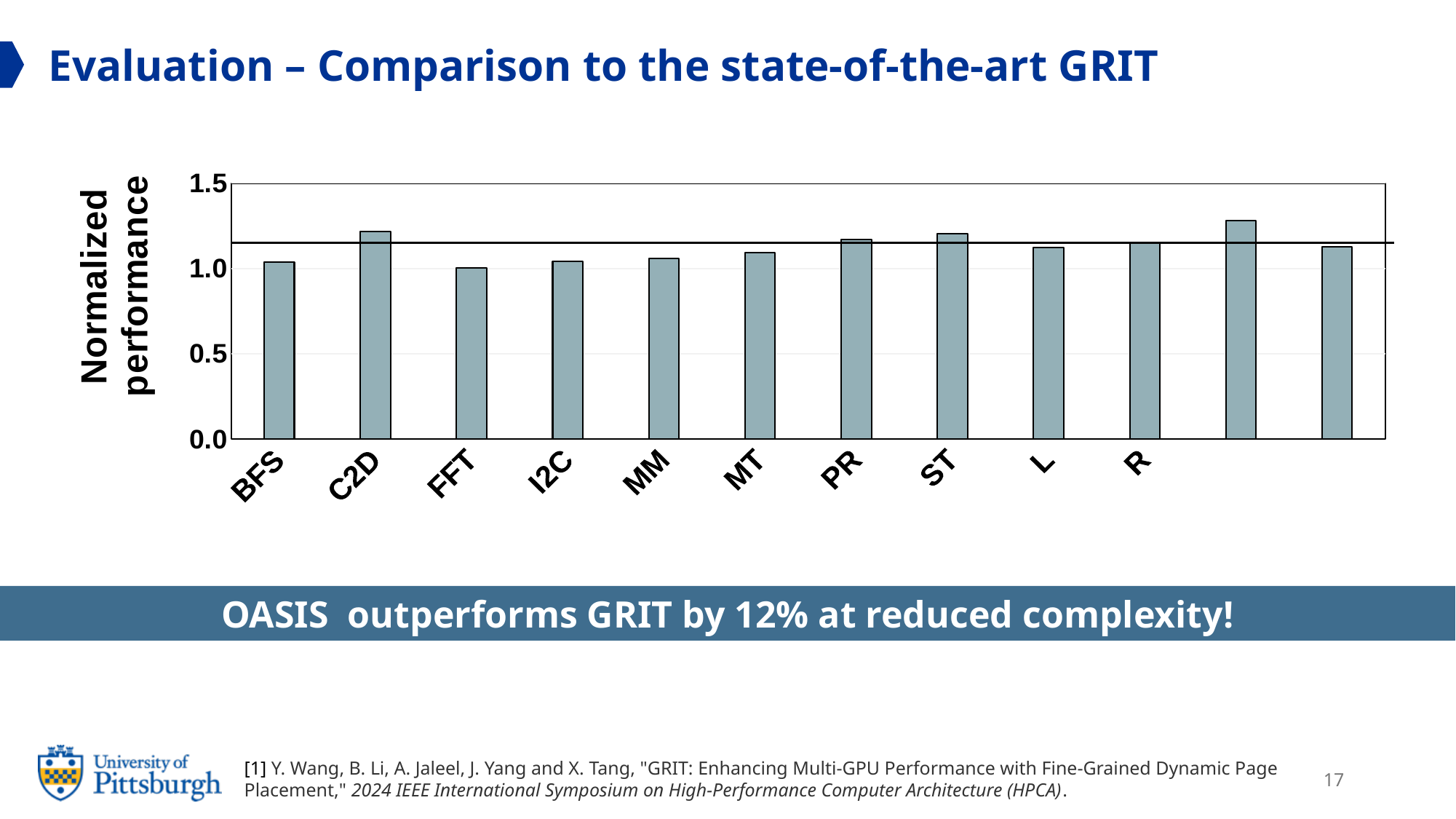
What is the label of the y axis of the chart? Normalized performance Is the value for C2D greater or less than 1.0? greater Is the value for ST greater or less than 1.5? less What kind of chart is shown on the slide? bar chart Which has the larger value, ST or I2C? ST What is the highest tick value shown on the y axis? 1.5 Which has the larger value, C2D or FFT? C2D Is the value for PR greater or less than 1.0? greater Which has the larger value, PR or MT? PR